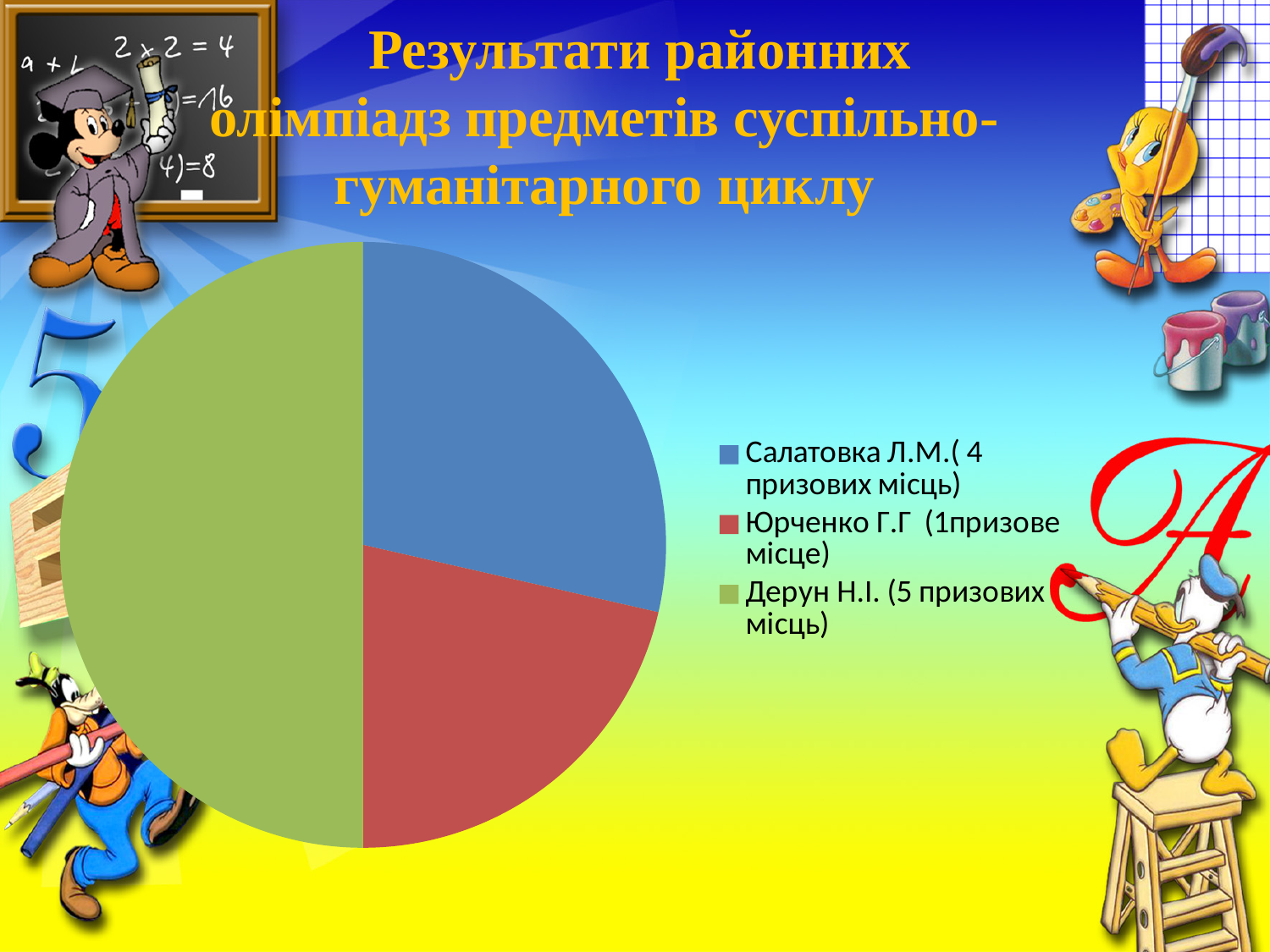
How many entries does the legend of the pie chart list? 3 Which slice is larger: Салатовка Л.М. or Юрченко Г.Г? Салатовка Л.М. Which teacher has the largest slice of the pie chart? Дерун Н.І. According to the legend, how many prize places does Юрченко Г.Г have? 1 According to the legend, how many prize places (призових місць) does Салатовка Л.М. have? 4 According to the legend, how many prize places does Дерун Н.І. have? 5 Which teacher has the smallest slice of the pie chart? Юрченко Г.Г What colour is the slice for Дерун Н.І. in the pie chart? green What share of the pie does the slice for Дерун Н.І. take up? 50% How many more prize places does Дерун Н.І. have than Салатовка Л.М.? 1 How many slices does the pie chart have? 3 What kind of chart is shown on the slide? pie chart